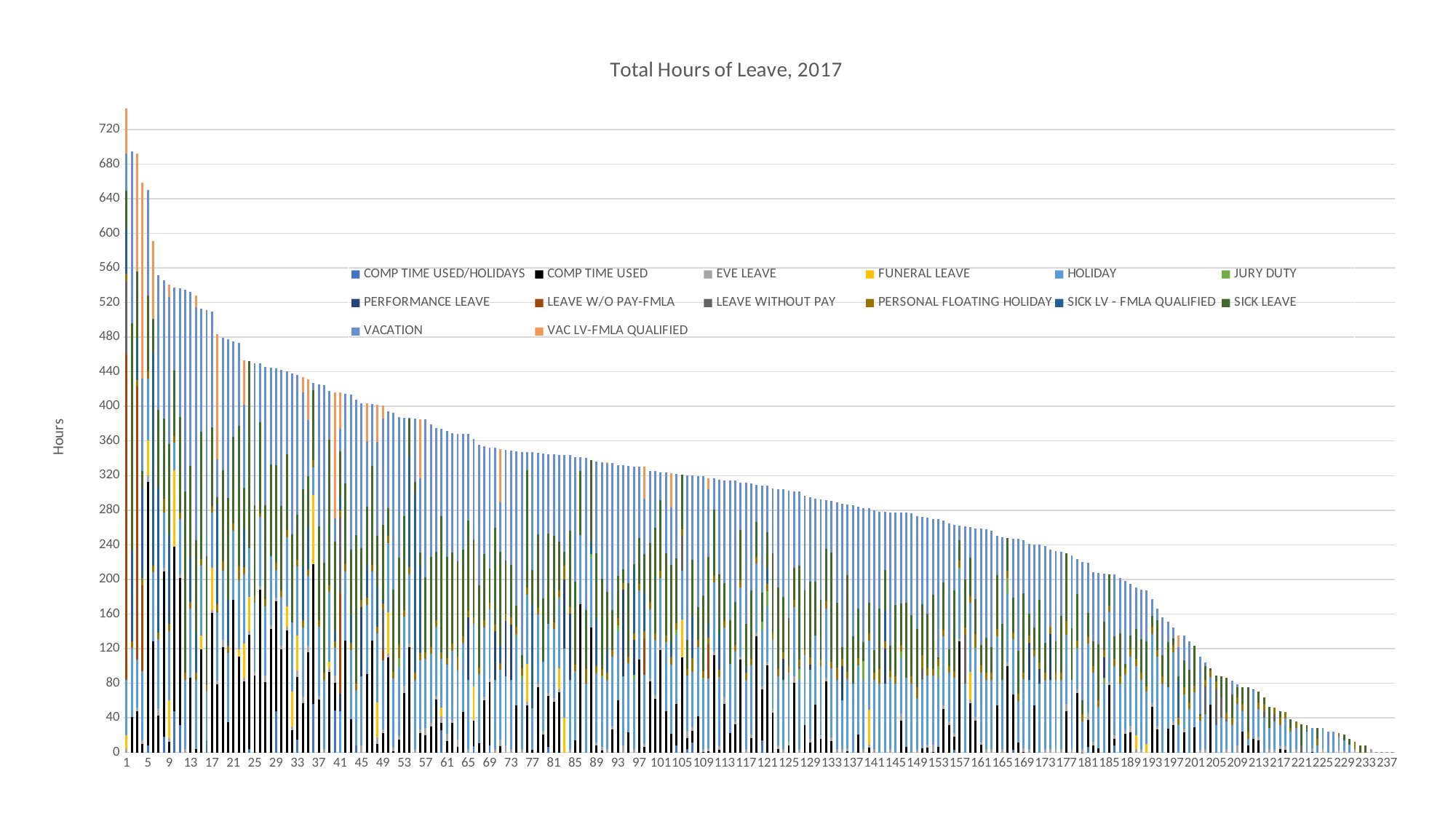
Which category on the x axis has the tallest stacked bar? 1 What is the title of the chart? Total Hours of Leave, 2017 Do the total bar heights rise or fall moving from left to right along the x axis? fall What is the label on the vertical axis? Hours How many series does the legend list? 14 Which has the larger total, category 9 or category 101? 9 Is the total for category 1 greater or less than 720? greater Is the total for category 229 greater or less than 40? less Is the total for category 101 greater or less than 360? less What kind of chart is shown on the slide? stacked bar chart